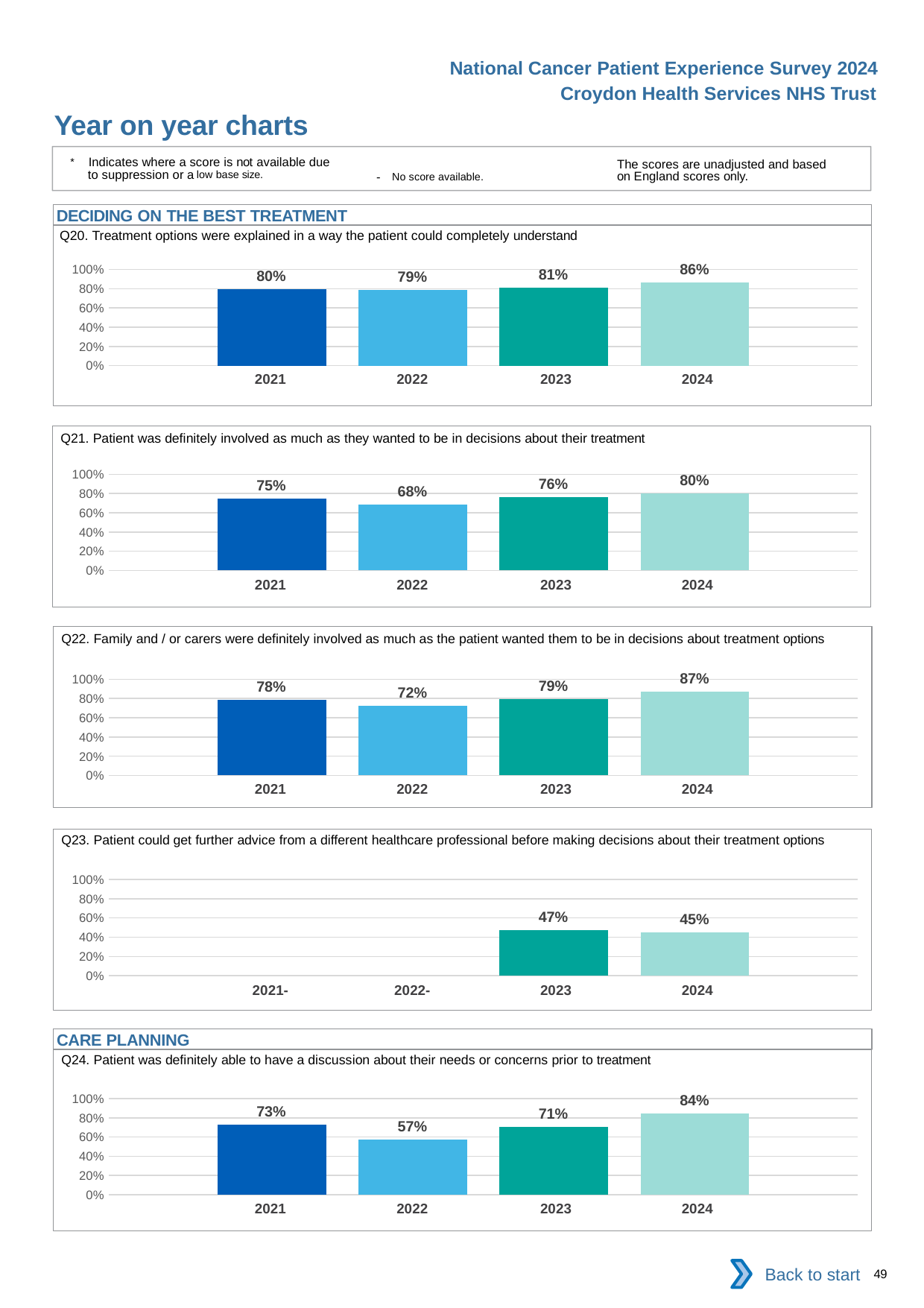
In the Q21 chart, which year has the lowest value? 2022 What kind of chart is the Q21 chart? bar chart In the Q23 chart, how many years have a bar plotted? 2 In the Q24 chart, which year has the highest value? 2024 In the Q20 chart, what is the value for 2024? 86% In the Q21 chart, is the value for 2024 greater or less than 60%? greater In the Q22 chart, what is the difference between the 2024 and 2021 values? 9% In the Q23 chart, which is larger, the value for 2023 or the value for 2024? 2023 In the Q22 chart, how many years are shown on the x axis? 4 In the Q24 chart, what is the value for 2022? 57% Which section heading appears above the Q24 chart? CARE PLANNING In the Q20 chart, what is the difference between the 2024 and 2022 values? 7%